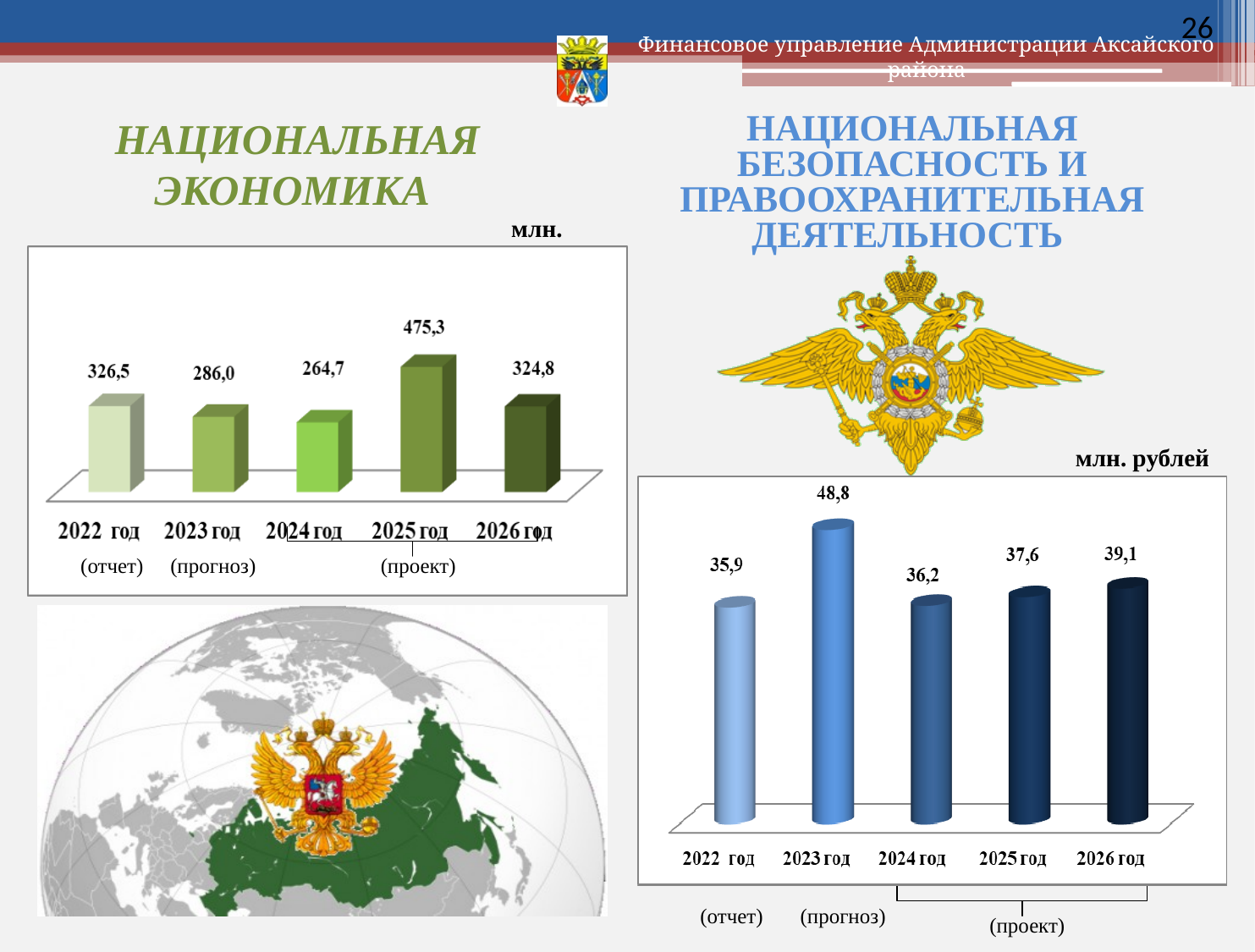
In the НАЦИОНАЛЬНАЯ ЭКОНОМИКА chart, which year has the highest value? 2025 год In the НАЦИОНАЛЬНАЯ ЭКОНОМИКА chart, what is the value for 2022 год? 326,5 In the НАЦИОНАЛЬНАЯ БЕЗОПАСНОСТЬ И ПРАВООХРАНИТЕЛЬНАЯ ДЕЯТЕЛЬНОСТЬ chart, which year has the lowest value? 2022 год What kind of chart is the НАЦИОНАЛЬНАЯ БЕЗОПАСНОСТЬ И ПРАВООХРАНИТЕЛЬНАЯ ДЕЯТЕЛЬНОСТЬ chart? Bar chart In the НАЦИОНАЛЬНАЯ ЭКОНОМИКА chart, what is the difference between the values for 2025 год and 2024 год? 210,6 In the НАЦИОНАЛЬНАЯ БЕЗОПАСНОСТЬ И ПРАВООХРАНИТЕЛЬНАЯ ДЕЯТЕЛЬНОСТЬ chart, what is the value for 2026 год? 39,1 In the НАЦИОНАЛЬНАЯ БЕЗОПАСНОСТЬ И ПРАВООХРАНИТЕЛЬНАЯ ДЕЯТЕЛЬНОСТЬ chart, which is larger, the value for 2025 год or 2024 год? 2025 год In the НАЦИОНАЛЬНАЯ ЭКОНОМИКА chart, what is the value for 2025 год? 475,3 In the НАЦИОНАЛЬНАЯ БЕЗОПАСНОСТЬ И ПРАВООХРАНИТЕЛЬНАЯ ДЕЯТЕЛЬНОСТЬ chart, what is the value for 2023 год? 48,8 In the НАЦИОНАЛЬНАЯ ЭКОНОМИКА chart, which year has the lowest value? 2024 год In the НАЦИОНАЛЬНАЯ ЭКОНОМИКА chart, how many years are shown? 5 In the НАЦИОНАЛЬНАЯ БЕЗОПАСНОСТЬ И ПРАВООХРАНИТЕЛЬНАЯ ДЕЯТЕЛЬНОСТЬ chart, what is the difference between the values for 2023 год and 2022 год? 12,9